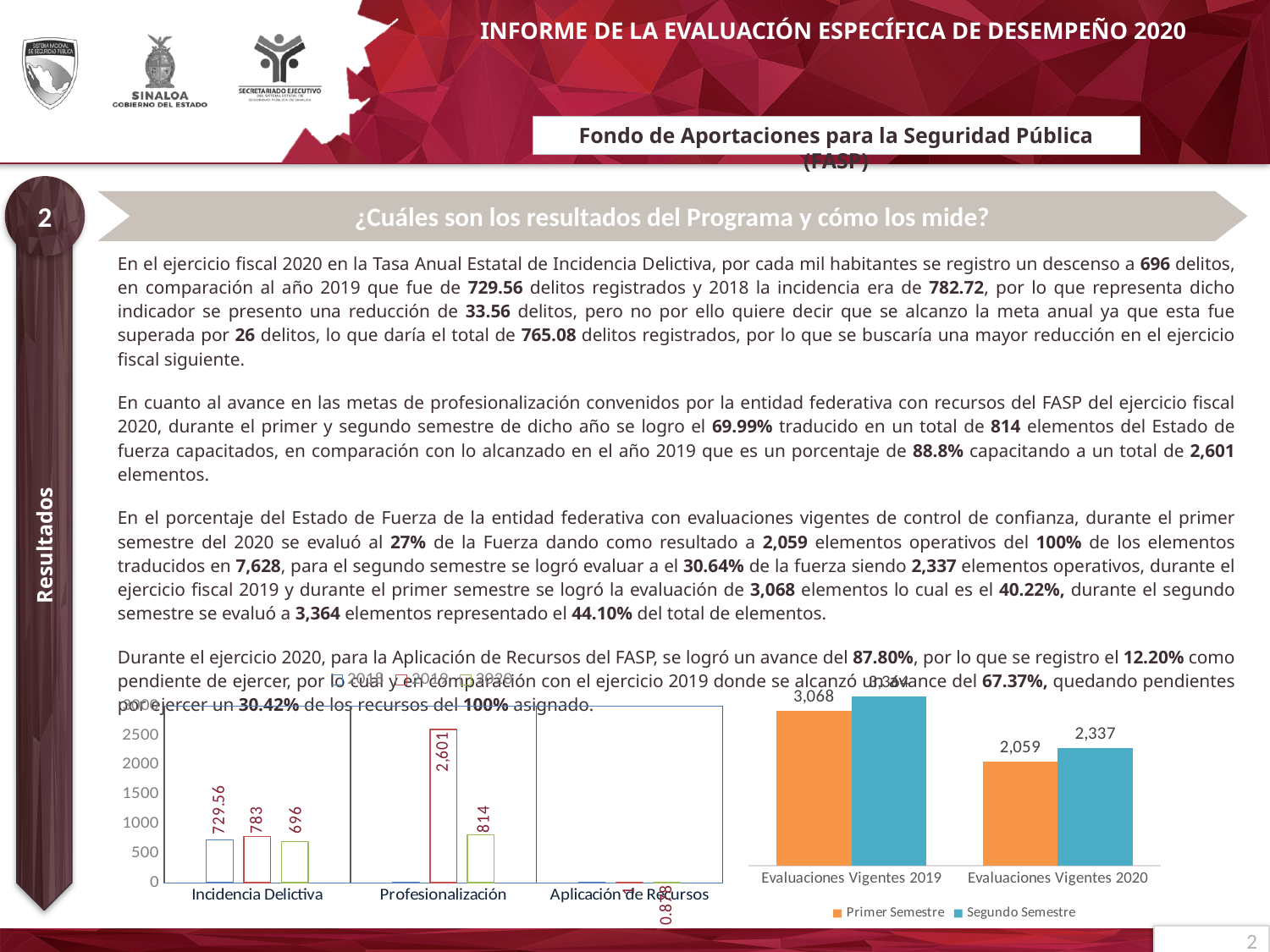
In the right chart, what is the value for Segundo Semestre under Evaluaciones Vigentes 2020? 2,337 In the left chart, is the value labelled 814 for Profesionalización greater or less than 1000? less How many series does the legend of the right chart list? 2 In the right chart, what is the value for Segundo Semestre under Evaluaciones Vigentes 2019? 3,364 In the right chart, what is the value for Primer Semestre under Evaluaciones Vigentes 2019? 3,068 What kind of chart is the right chart? Bar chart In the right chart, what is the value for Primer Semestre under Evaluaciones Vigentes 2020? 2,059 In the left chart, what is the highest value labelled for Profesionalización? 2,601 In the right chart, which is larger for Evaluaciones Vigentes 2019: Primer Semestre or Segundo Semestre? Segundo Semestre In the right chart, what is the difference between Segundo Semestre and Primer Semestre for Evaluaciones Vigentes 2020? 278 In the left chart, what is the lowest value labelled for Incidencia Delictiva? 696 How many categories are shown on the x axis of the left chart? 3